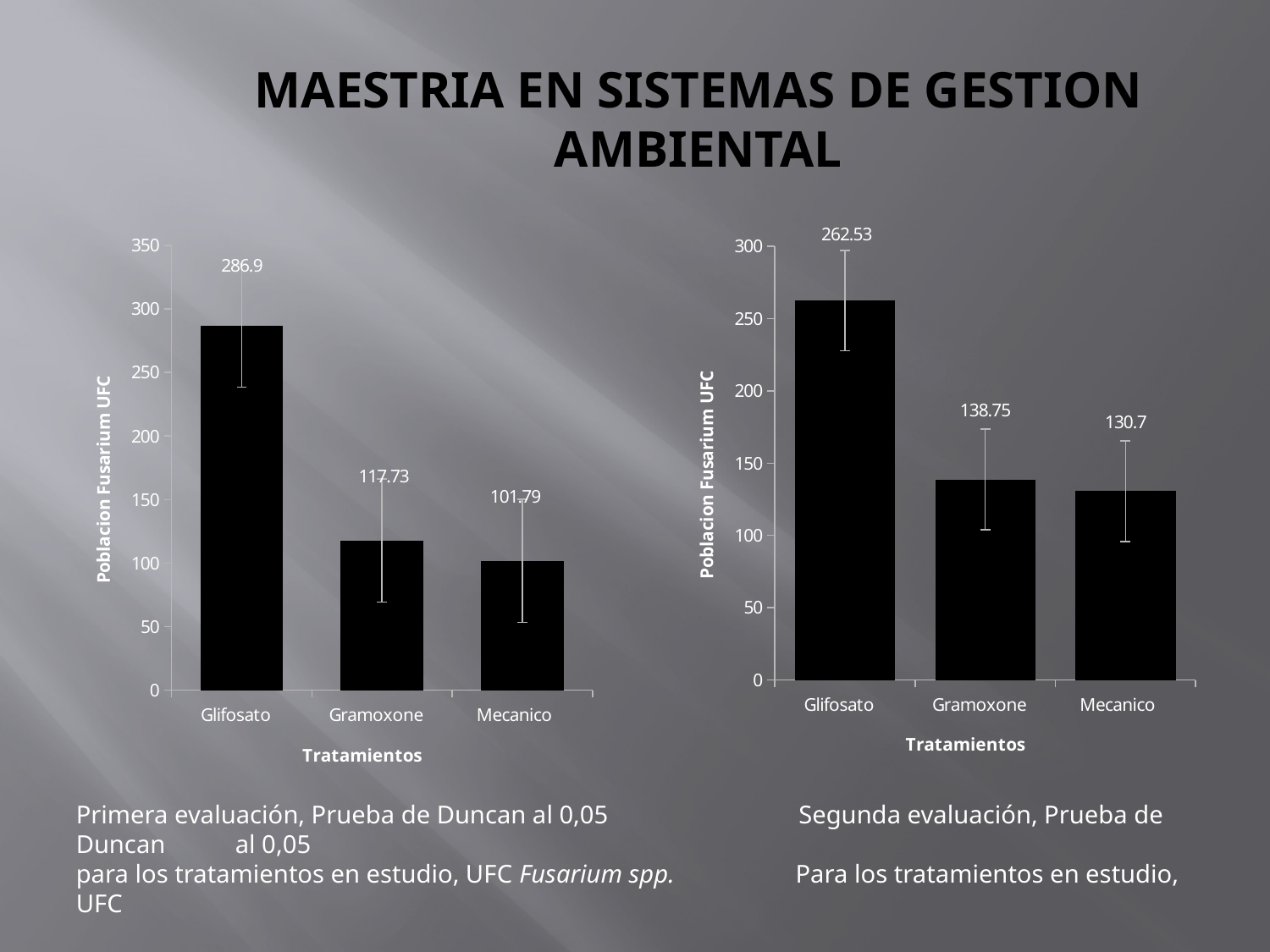
In the left chart, is the value for Mecanico greater or less than 150? less How many treatments are shown in the right chart? 3 In the right chart, what is the difference between the values for Gramoxone and Mecanico? 8.05 In the right chart, what is the value for Mecanico? 130.7 In the left chart, what is the value for Glifosato? 286.9 In the left chart, which treatment has the lowest value? Mecanico In the right chart, which is larger, the value for Gramoxone or the value for Mecanico? Gramoxone What kind of chart is the left chart? bar chart In the left chart, what is the difference between the values for Glifosato and Gramoxone? 169.17 In the right chart, which treatment has the highest value? Glifosato What is the y-axis label of the right chart? Poblacion Fusarium UFC In the left chart, what is the value for Gramoxone? 117.73